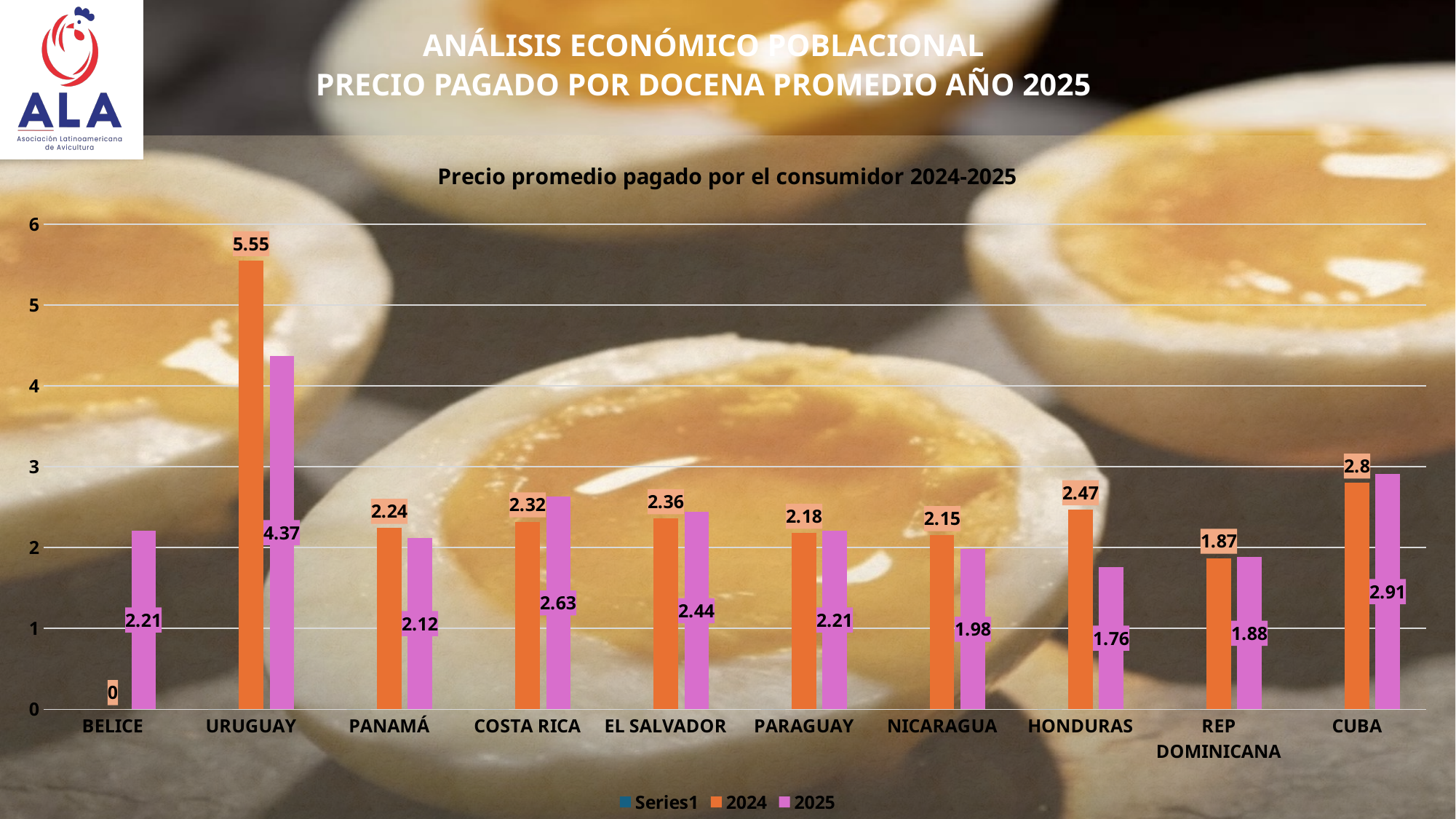
Which country has the lowest 2024 value? Belice What is the difference between the 2024 and 2025 values for Uruguay? 1.18 What is the 2024 value for Rep Dominicana? 1.87 Which country has the highest 2025 value? Uruguay Which is larger for Cuba, the 2024 value or the 2025 value? 2025 What is the 2024 value for Uruguay? 5.55 What is the 2025 value for Honduras? 1.76 How many countries are shown on the x axis? 10 How many series does the legend list? 3 What is the 2025 value for Costa Rica? 2.63 Is the 2025 value for Nicaragua greater or less than 2? less What kind of chart is shown on the slide? bar chart